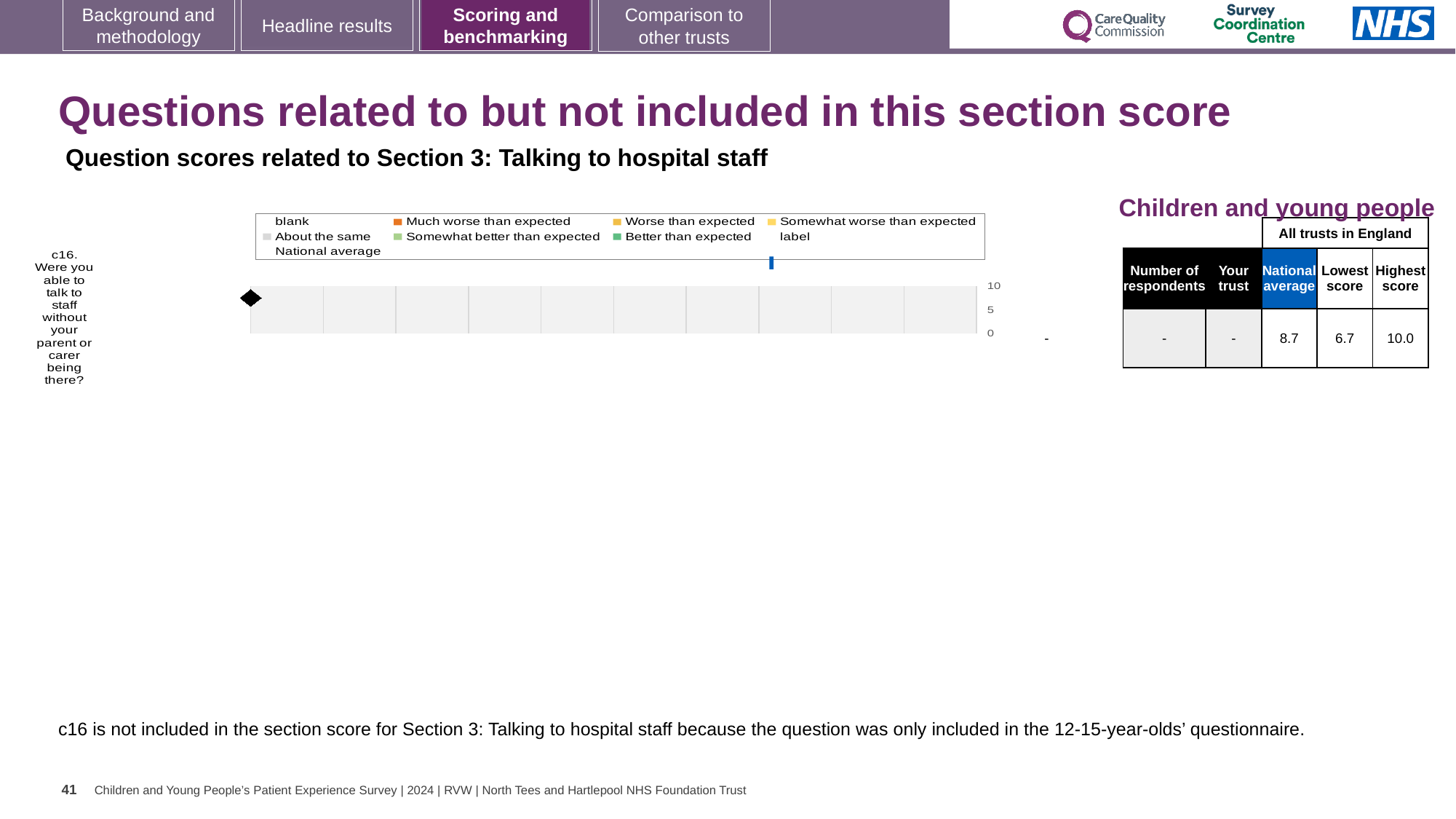
What kind of chart is shown on the slide? bar chart How many questions (categories) are plotted on the chart? 1 What is the difference between the highest score and the lowest score for c16 in the table? 3.3 What is the lowest score among all trusts in England for c16 shown in the table? 6.7 What is the highest value shown on the chart's axis? 10 What value is shown for 'Your trust' for c16 in the table? - Is the national average for c16 greater or less than 5? greater Which is larger for c16: the national average or the lowest score? national average What is the national average score for c16 shown in the table? 8.7 What is the highest score among all trusts in England for c16 shown in the table? 10.0 Which question is plotted on the chart? c16. Were you able to talk to staff without your parent or carer being there?